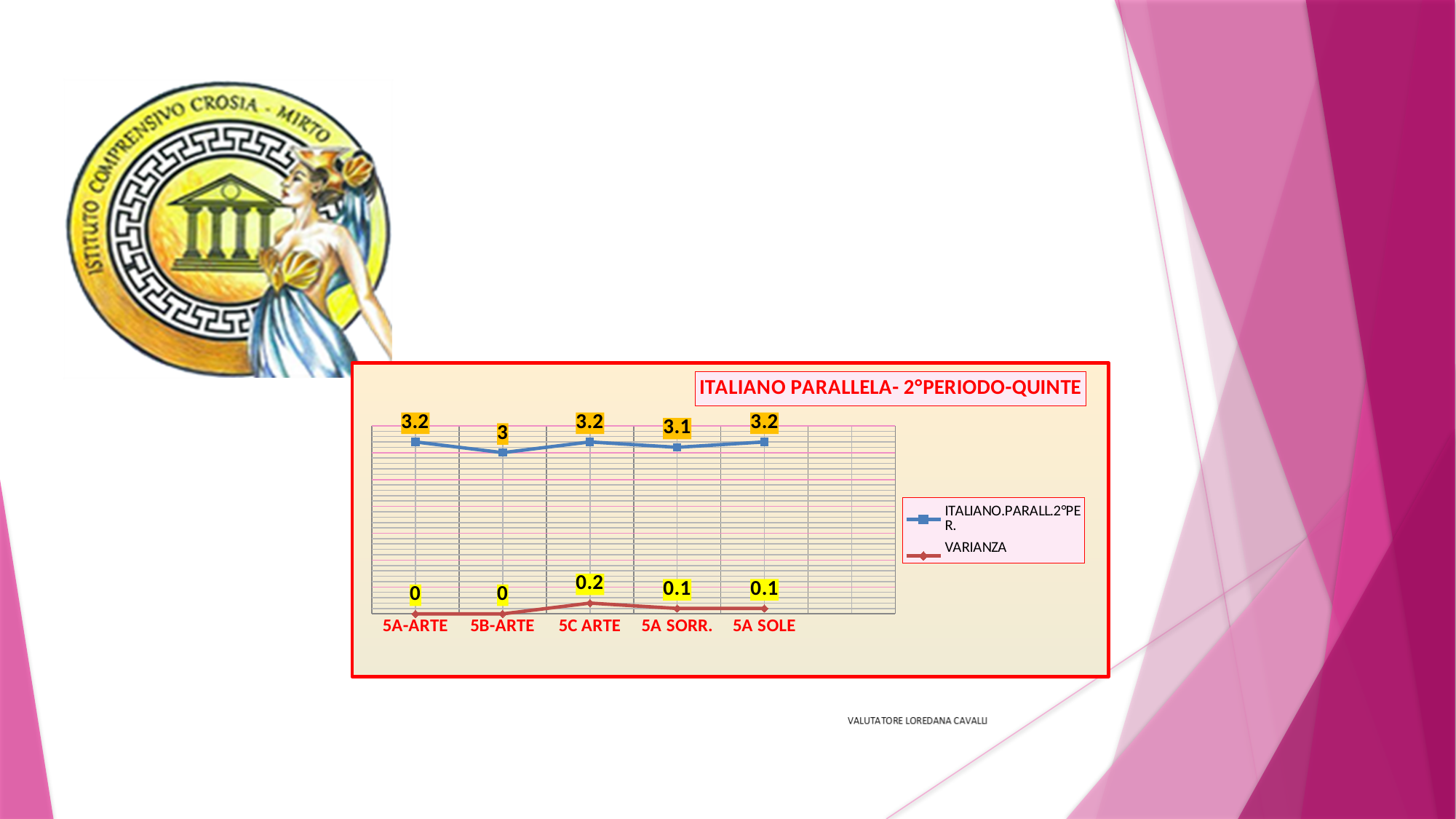
What is the ITALIANO.PARALL.2°PER. value for 5A SORR.? 3.1 What is the ITALIANO.PARALL.2°PER. value for 5B-ARTE? 3 What is the title of the chart? ITALIANO PARALLELA- 2°PERIODO-QUINTE What is the VARIANZA value for 5A-ARTE? 0 What is the VARIANZA value for 5C ARTE? 0.2 What type of chart is shown on the slide? line chart Which is larger, the ITALIANO.PARALL.2°PER. value for 5C ARTE or for 5A SORR.? 5C ARTE How many series does the legend list? 2 Which category has the highest VARIANZA value? 5C ARTE How many categories are shown on the x axis? 5 What is the difference between the ITALIANO.PARALL.2°PER. values for 5A-ARTE and 5B-ARTE? 0.2 Which category has the lowest ITALIANO.PARALL.2°PER. value? 5B-ARTE